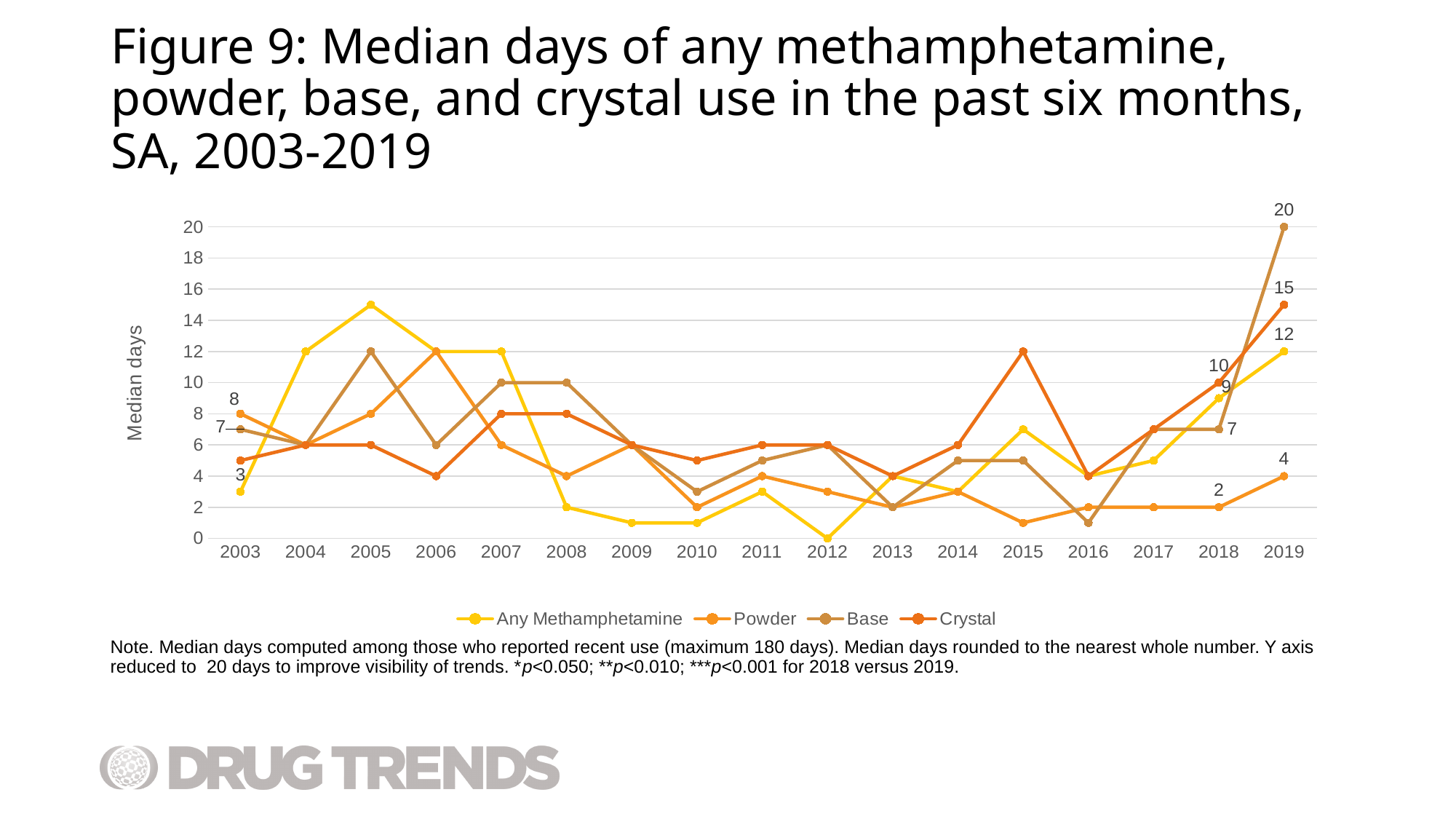
What is the median days value for Any Methamphetamine in 2018? 9 What is the median days value for Crystal in 2019? 15 Which series has the lowest value in 2019? Powder What is the median days value for Powder in 2003? 8 How many years are shown on the x axis? 17 In 2019, which is larger: the value for Powder or the value for Any Methamphetamine? Any Methamphetamine How many series does the legend list? 4 Is the value for Any Methamphetamine in 2005 greater or less than 14? greater What is the difference between the Base and Crystal values in 2019? 5 What is the median days value for Base in 2019? 20 Which series has the highest value in 2019? Base What kind of chart is shown on the slide? Line chart